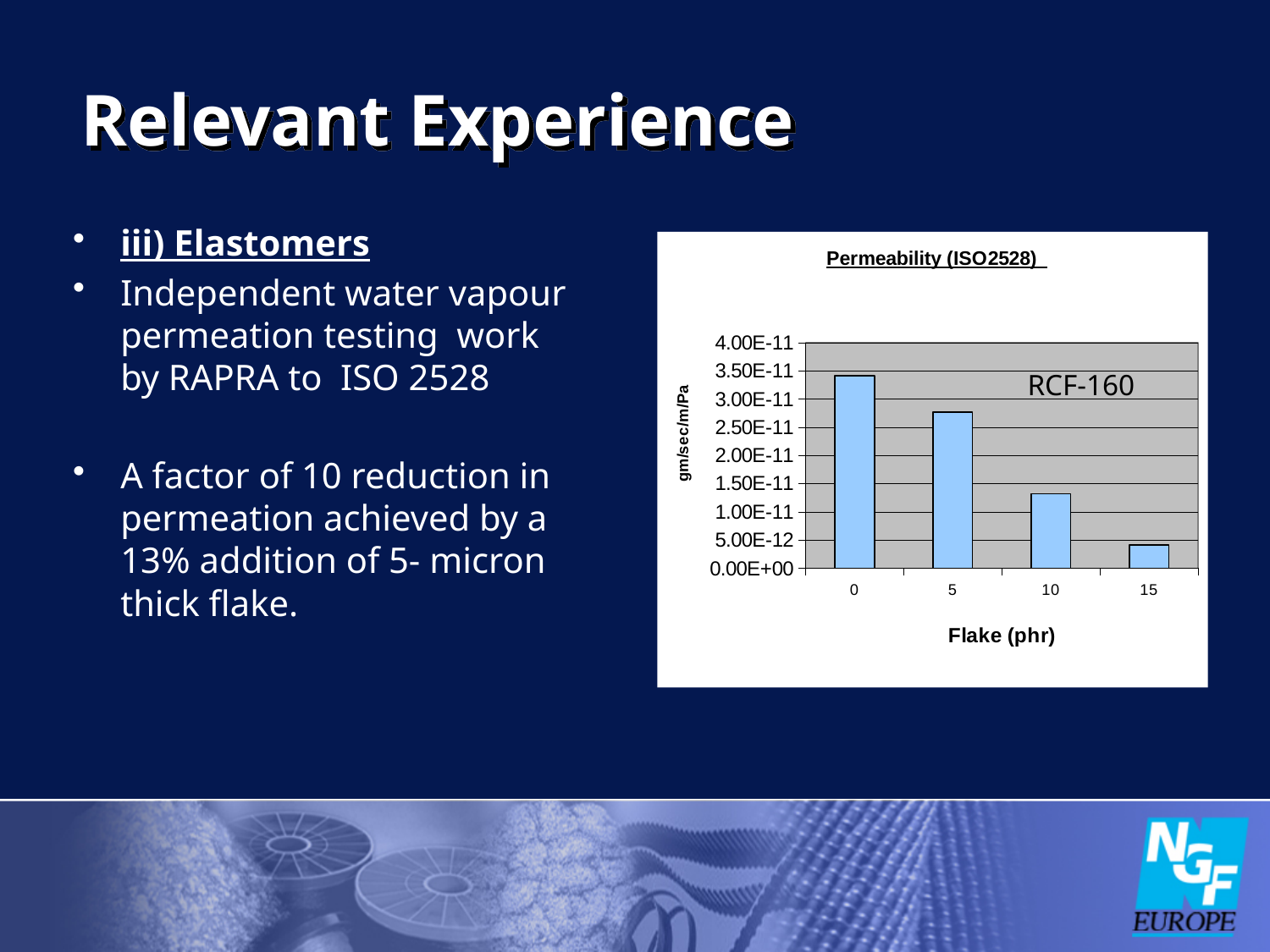
Do the permeability values rise or fall as the flake content increases along the x axis? fall Is the permeability value for 10 phr flake greater or less than 1.50E-11? less What is the label on the x axis of the chart? Flake (phr) What is the title of the chart? Permeability (ISO2528) Which has the larger permeability, 5 phr flake or 10 phr flake? 5 phr Which flake level (phr) has the highest permeability? 0 Is the permeability value for 5 phr flake greater or less than 2.50E-11? greater What kind of chart is shown on the slide? bar chart How many bars (flake levels) are plotted in the Permeability (ISO2528) chart? 4 Is the permeability value for 0 phr flake greater or less than 3.00E-11? greater Which flake level (phr) has the lowest permeability? 15